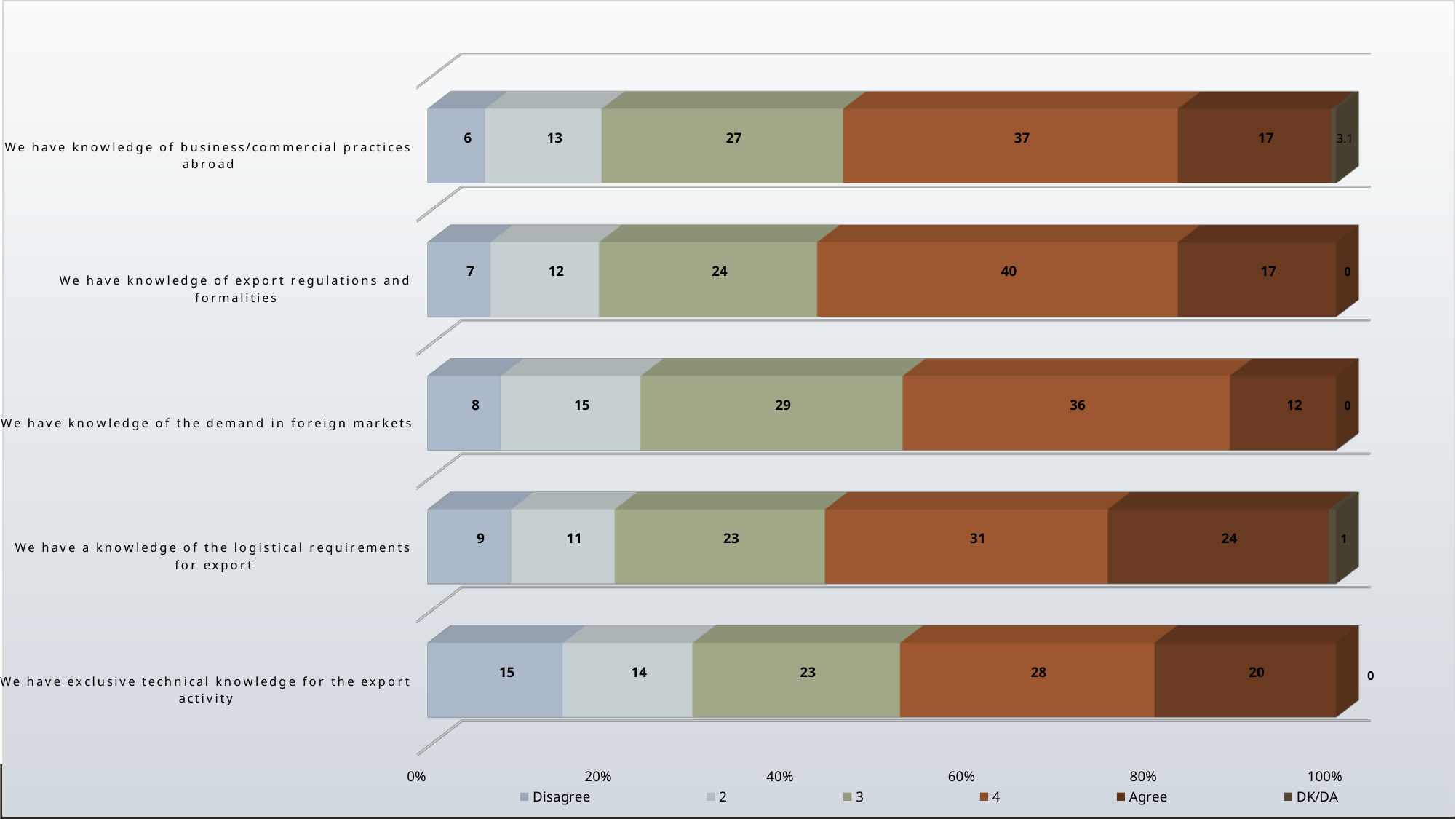
How many series does the legend list? 6 Which category has the highest "Disagree" value? We have exclusive technical knowledge for the export activity Which category has the lowest "Agree" value? We have knowledge of the demand in foreign markets Which has a larger "Agree" value: "We have a knowledge of the logistical requirements for export" or "We have knowledge of business/commercial practices abroad"? We have a knowledge of the logistical requirements for export What is the value of the "Agree" series for "We have a knowledge of the logistical requirements for export"? 24 What is the value of series "4" for "We have knowledge of export regulations and formalities"? 40 What is the "Disagree" value for "We have exclusive technical knowledge for the export activity"? 15 What kind of chart is shown on the slide? Stacked bar chart How many categories (statements) are shown in the chart? 5 What is the DK/DA value for "We have knowledge of business/commercial practices abroad"? 3.1 For "We have knowledge of the demand in foreign markets", what is the difference between the value of series "4" and the "Disagree" value? 28 What is the first entry in the chart's legend? Disagree